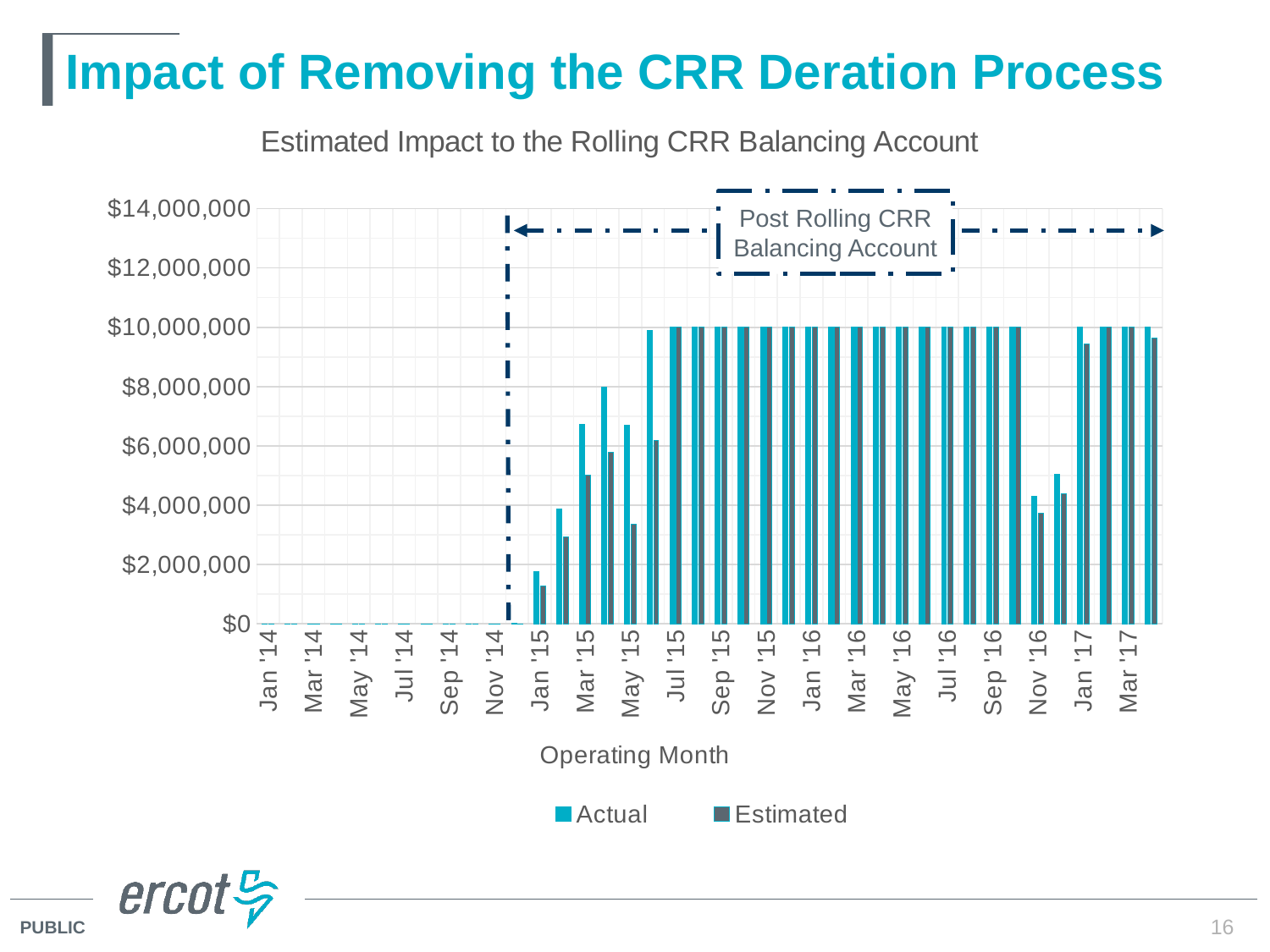
For Nov '16, which is larger, the Actual value or the Estimated value? Actual Is the Actual value for Mar '15 greater or less than $6,000,000? greater Is the Estimated value for Mar '15 greater or less than $6,000,000? less How many series does the legend list? 2 For Mar '15, which is larger, the Actual value or the Estimated value? Actual Is the Actual value for Jan '15 greater or less than $2,000,000? less Do the Actual values rise or fall from Jan '15 to Jul '15? rise What kind of chart is shown on the slide? bar chart What is the x-axis title of the chart? Operating Month What is the title of the chart? Estimated Impact to the Rolling CRR Balancing Account